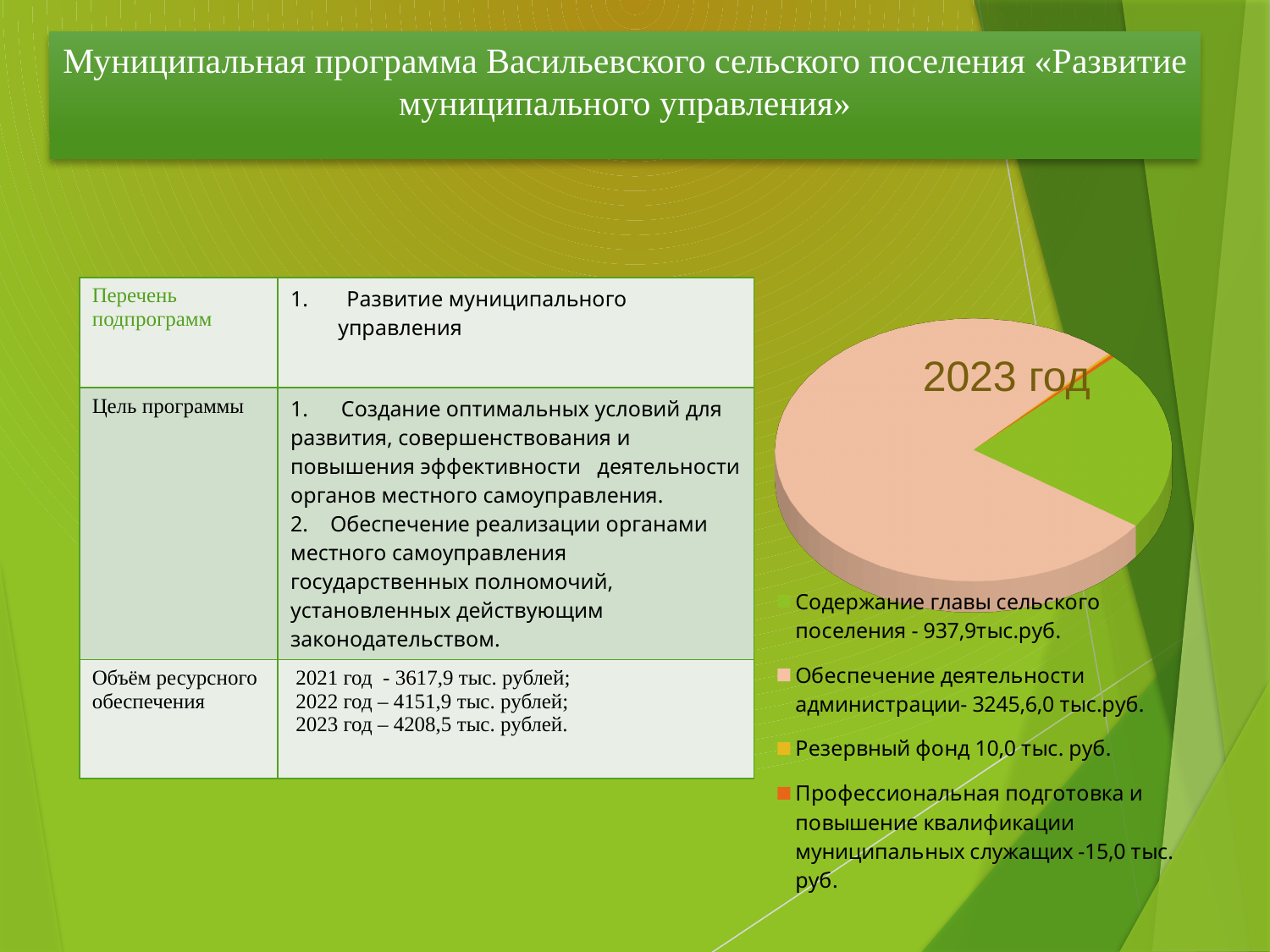
What kind of chart is shown on the right side of the slide? Pie chart By how much does «Профессиональная подготовка и повышение квалификации муниципальных служащих» exceed «Резервный фонд» in the pie chart? 5,0 тыс. руб. What value is given for «Содержание главы сельского поселения» in the pie chart legend? 937,9 тыс.руб. How many categories does the legend of the pie chart list? 4 What is the title of the pie chart? 2023 год What colour is the largest slice of the pie chart? Peach (light pink) Which category has the smallest value in the pie chart? Резервный фонд Which category takes the largest slice of the pie chart? Обеспечение деятельности администрации What value is given for «Резервный фонд» in the pie chart legend? 10,0 тыс. руб. Which is larger in the pie chart: «Обеспечение деятельности администрации» or «Содержание главы сельского поселения»? Обеспечение деятельности администрации What value is given for «Профессиональная подготовка и повышение квалификации муниципальных служащих» in the pie chart legend? 15,0 тыс. руб. Which is larger in the pie chart: «Содержание главы сельского поселения» or «Резервный фонд»? Содержание главы сельского поселения